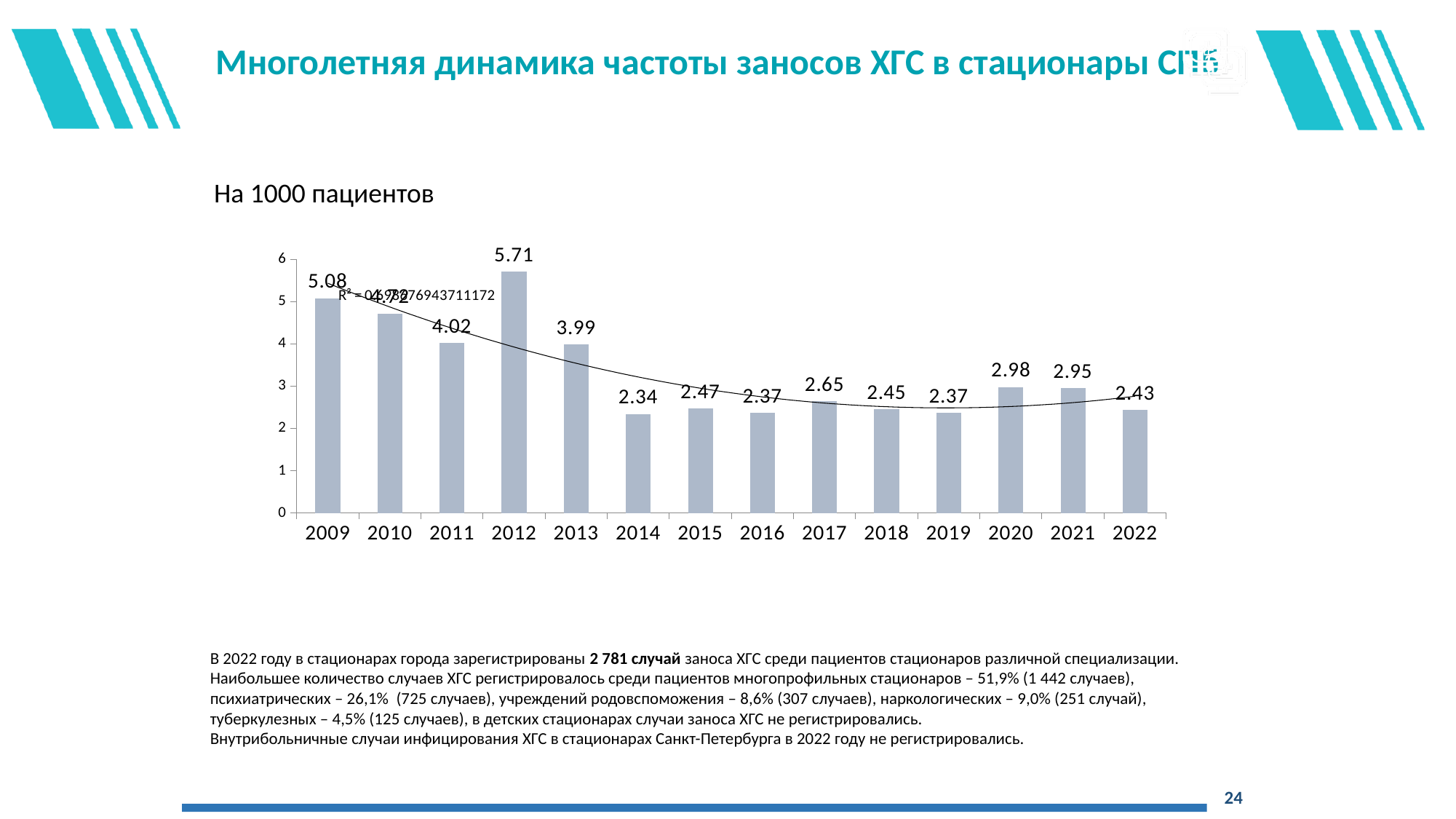
Is the value for 2015 greater or less than 3? less What is the value for 2022? 2.43 What is the difference between the values for 2009 and 2022? 2.65 What is the value for 2012? 5.71 How many years are shown on the x axis? 14 Which is larger, the value for 2017 or the value for 2018? 2017 What is the value for 2017? 2.65 What is the difference between the values for 2012 and 2013? 1.72 Which year has the highest value? 2012 Which year has the lowest value? 2014 What is the value for 2014? 2.34 What kind of chart is shown on the slide? bar chart